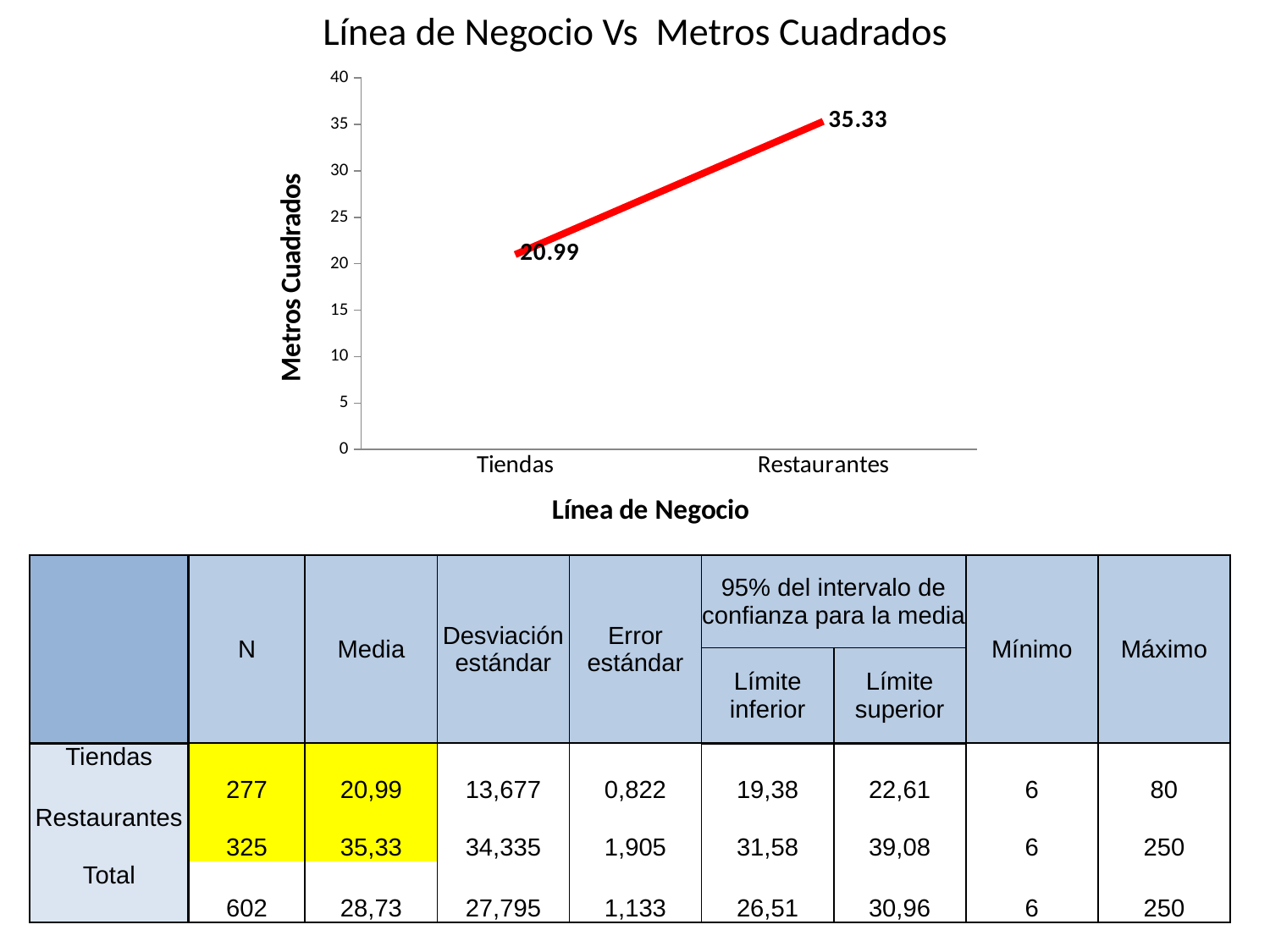
Is the value for Tiendas in the chart greater or less than 25? less Which category has the highest value in the chart? Restaurantes Do the values rise or fall from Tiendas to Restaurantes in the chart? rise Is the value for Restaurantes in the chart greater or less than 30? greater How many categories are plotted on the x axis of the chart? 2 What is the title of the chart? Línea de Negocio Vs Metros Cuadrados What kind of chart is shown on the slide? line chart Which is larger in the chart, the value for Tiendas or the value for Restaurantes? Restaurantes What is the value for Tiendas in the chart? 20.99 Which category has the lowest value in the chart? Tiendas What is the value for Restaurantes in the chart? 35.33 What is the difference between the values for Restaurantes and Tiendas in the chart? 14.34